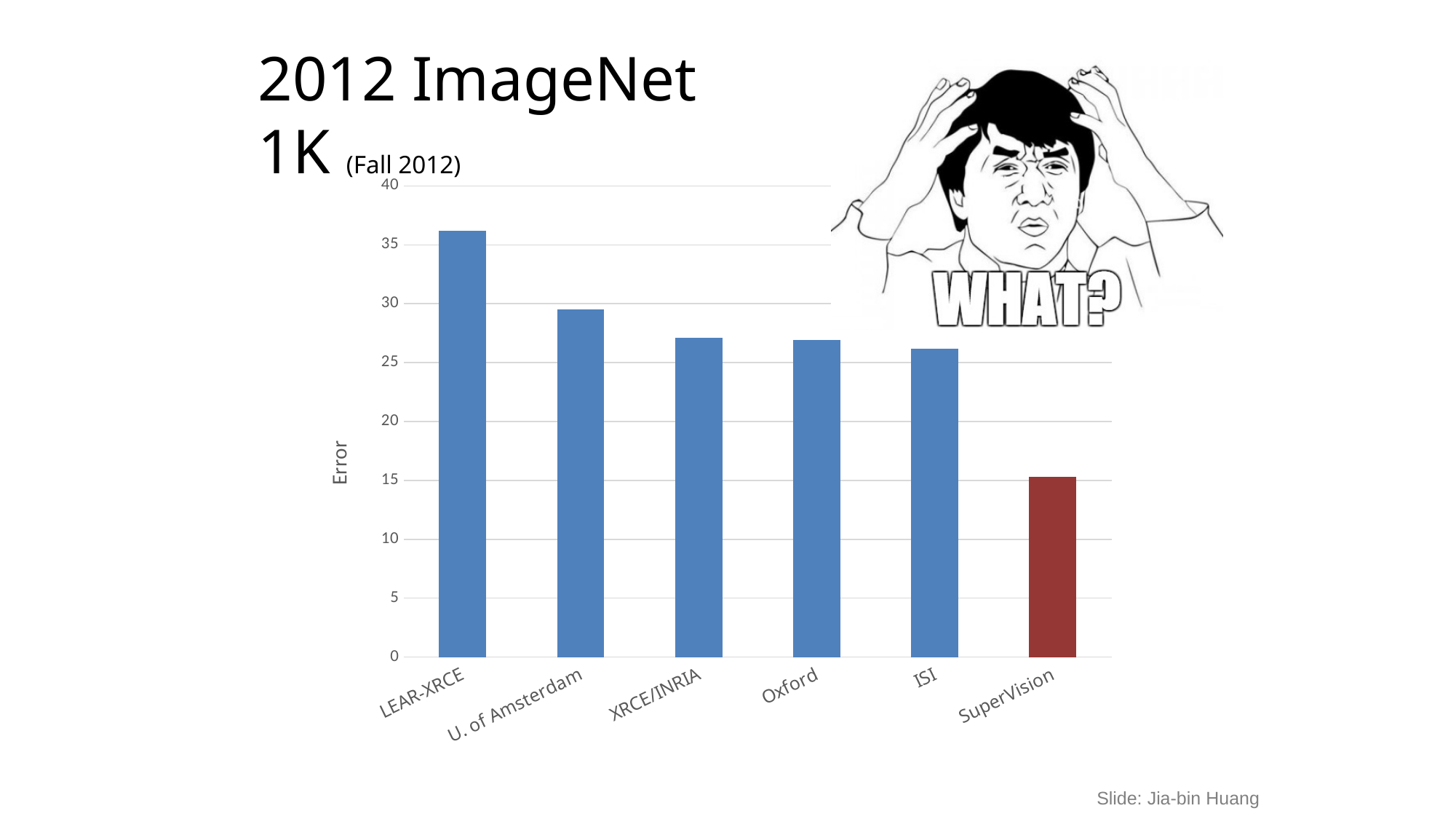
Is the error value for SuperVision greater or less than 20? less Which team has the highest error in the chart? LEAR-XRCE Is the error value for U. of Amsterdam greater or less than 30? less Is the error value for ISI greater or less than 25? greater What kind of chart is shown on the slide? bar chart What is the label on the vertical axis of the chart? Error How many categories (teams) are shown on the x axis of the chart? 6 Which team has the lowest error in the chart? SuperVision Do the error values generally rise or fall moving from left to right along the x axis? fall Which has a higher error, U. of Amsterdam or Oxford? U. of Amsterdam Which has a lower error, ISI or SuperVision? SuperVision